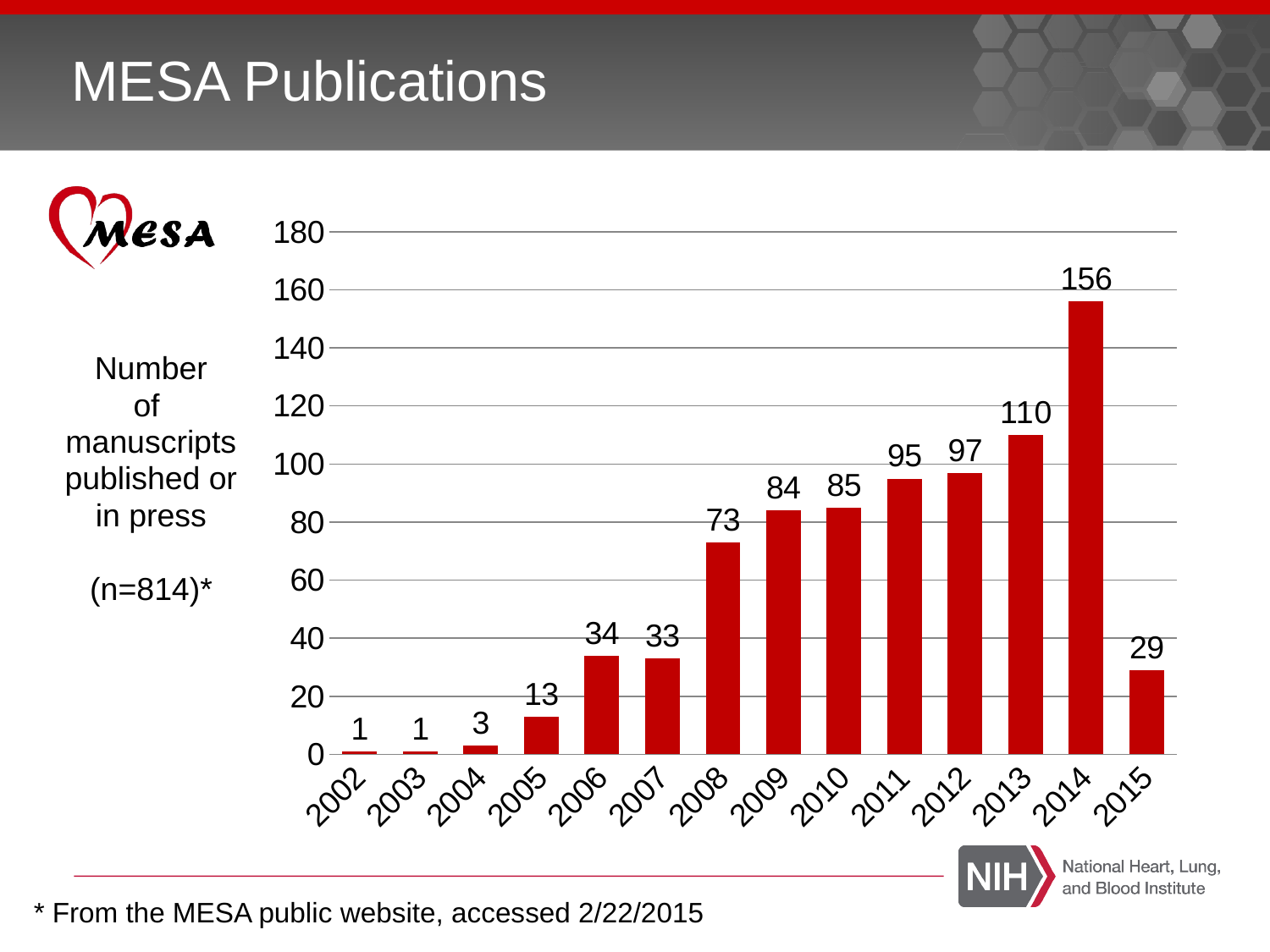
How many manuscripts were published or in press in 2014? 156 Which is larger, the value for 2009 or the value for 2011? 2011 Do the values generally rise or fall from 2002 to 2014? rise What is the value shown for 2008? 73 What kind of chart is shown on the slide? bar chart What is the difference between the values for 2014 and 2013? 46 What is the value shown for 2015? 29 What is the difference between the values for 2006 and 2007? 1 How many years are shown on the x axis? 14 Which year has the highest number of manuscripts? 2014 Is the value for 2012 greater or less than 80? greater What is the title of the slide containing the chart? MESA Publications